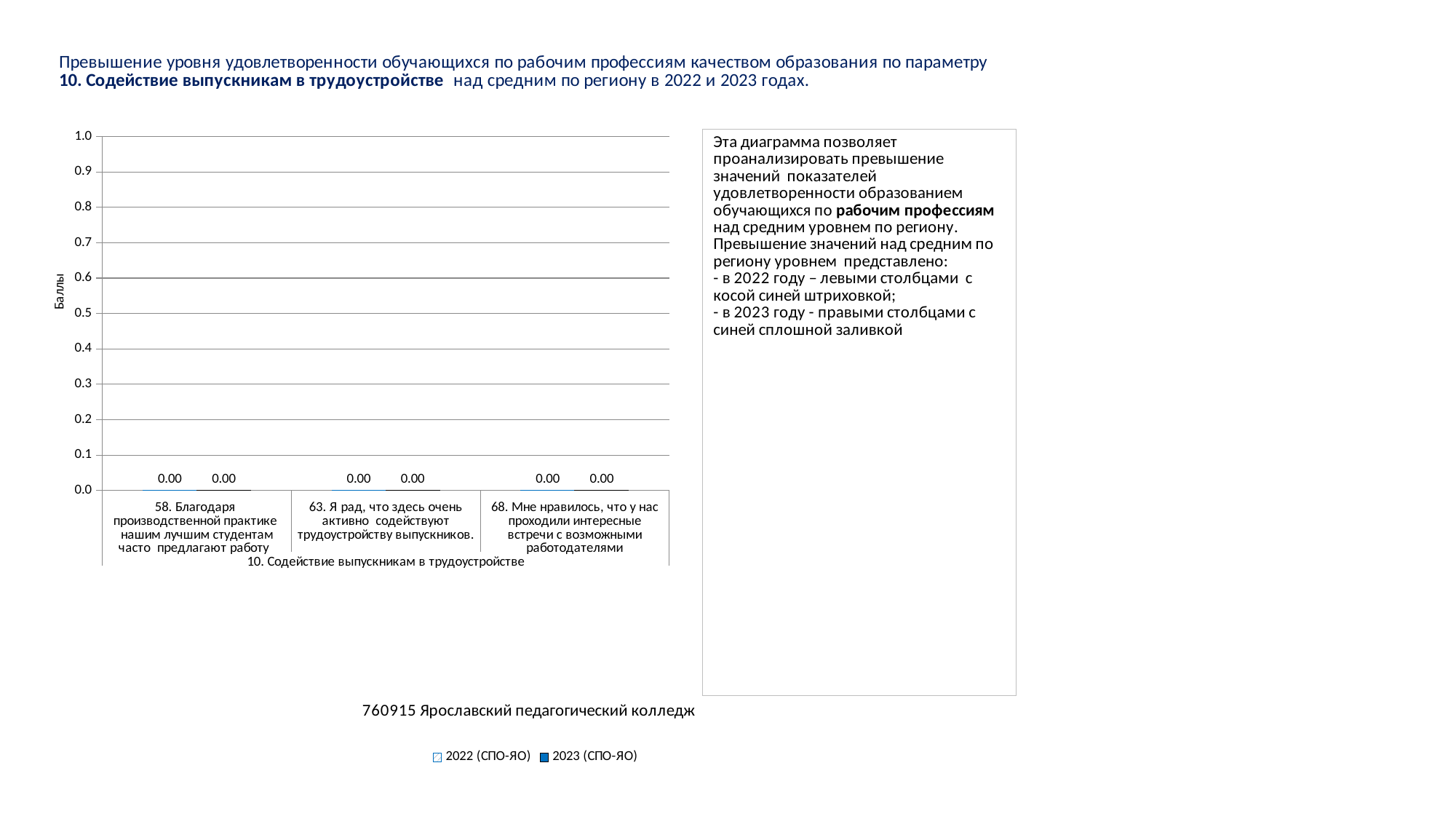
How many categories are shown on the x axis of the chart? 3 What is the difference between the 2022 (СПО-ЯО) and 2023 (СПО-ЯО) values for category 63? 0.00 How many series does the legend list? 2 What is the value for 2023 (СПО-ЯО) for category 63 (Я рад, что здесь очень активно содействуют трудоустройству выпускников)? 0.00 What is the value for 2023 (СПО-ЯО) for category 58 (Благодаря производственной практике нашим лучшим студентам часто предлагают работу)? 0.00 What is the value for 2022 (СПО-ЯО) for category 58 (Благодаря производственной практике нашим лучшим студентам часто предлагают работу)? 0.00 What is the highest value shown on the y axis of the chart? 1.0 What type of chart is shown on the slide? bar chart What are the two legend entries of the chart? 2022 (СПО-ЯО) and 2023 (СПО-ЯО) What is the value for 2022 (СПО-ЯО) for category 68 (Мне нравилось, что у нас проходили интересные встречи с возможными работодателями)? 0.00 What is the label of the y axis of the chart? Баллы Is the value for 2023 (СПО-ЯО) for category 68 greater or less than 0.5? less